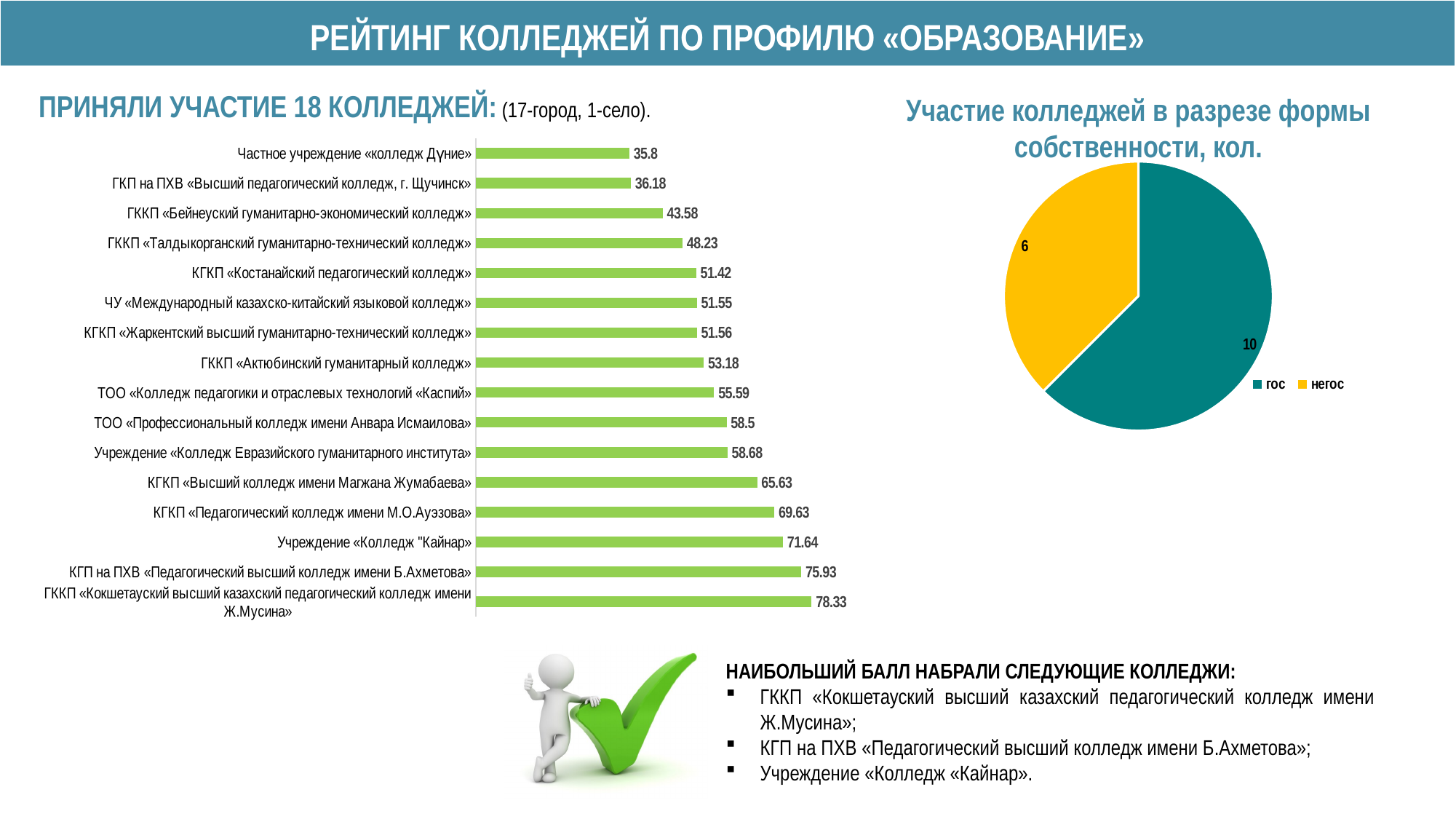
What type of chart is the chart on the left of the slide? Bar chart On the bar chart on the left, which college has the highest value? ГККП «Кокшетауский высший казахский педагогический колледж имени Ж.Мусина» On the bar chart on the left, which is larger: the value for ТОО «Колледж педагогики и отраслевых технологий «Каспий» or the value for ГККП «Талдыкорганский гуманитарно-технический колледж»? ТОО «Колледж педагогики и отраслевых технологий «Каспий» How many colleges are shown on the bar chart on the left? 16 On the bar chart on the left, what is the difference between the values for КГП на ПХВ «Педагогический высший колледж имени Б.Ахметова» and КГКП «Педагогический колледж имени М.О.Ауэзова»? 6.3 On the pie chart on the right, what share of the total does the гос slice represent? 62.5% On the pie chart on the right, what is the value for негос? 6 On the bar chart on the left, what is the value for ГККП «Бейнеуский гуманитарно-экономический колледж»? 43.58 How many entries does the legend of the pie chart on the right list? 2 On the pie chart on the right, what is the value for гос? 10 On the bar chart on the left, which college has the lowest value? Частное учреждение «колледж Дүние» On the bar chart on the left, what is the value for Учреждение «Колледж "Кайнар"»? 71.64